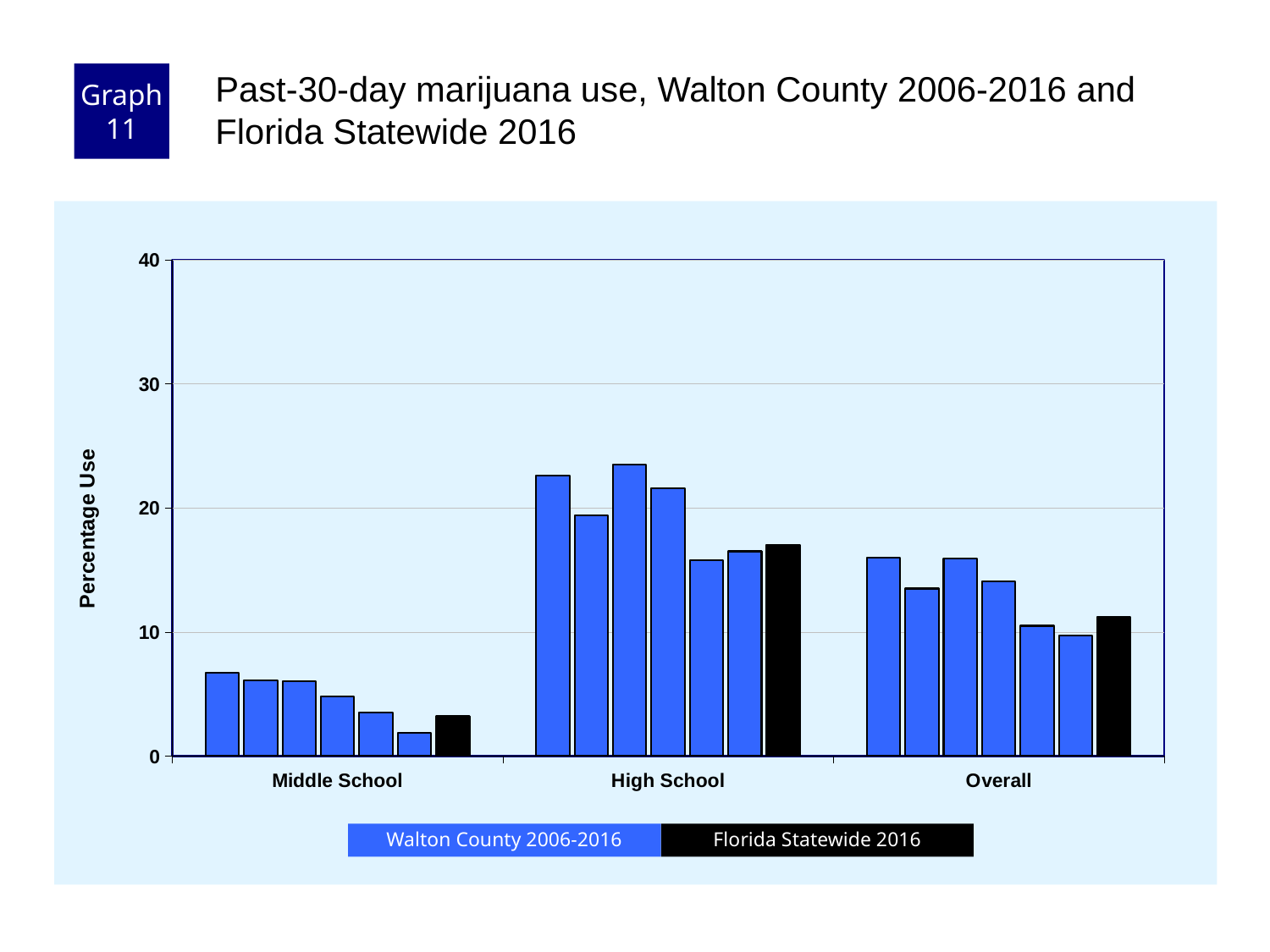
What colour represents Florida Statewide 2016 in the legend? black Is the Florida Statewide 2016 value for Overall greater or less than 20? less How many series does the legend list? 2 Which category has the highest bars overall? High School Which category has the lowest bars overall? Middle School What kind of chart is shown on the slide? bar chart What is the label on the y axis? Percentage Use Is the Florida Statewide 2016 value for High School greater or less than 10? greater How many categories are shown on the x axis? 3 Which is larger: the Florida Statewide 2016 value for High School or for Middle School? High School Is the Florida Statewide 2016 value for High School greater or less than 20? less